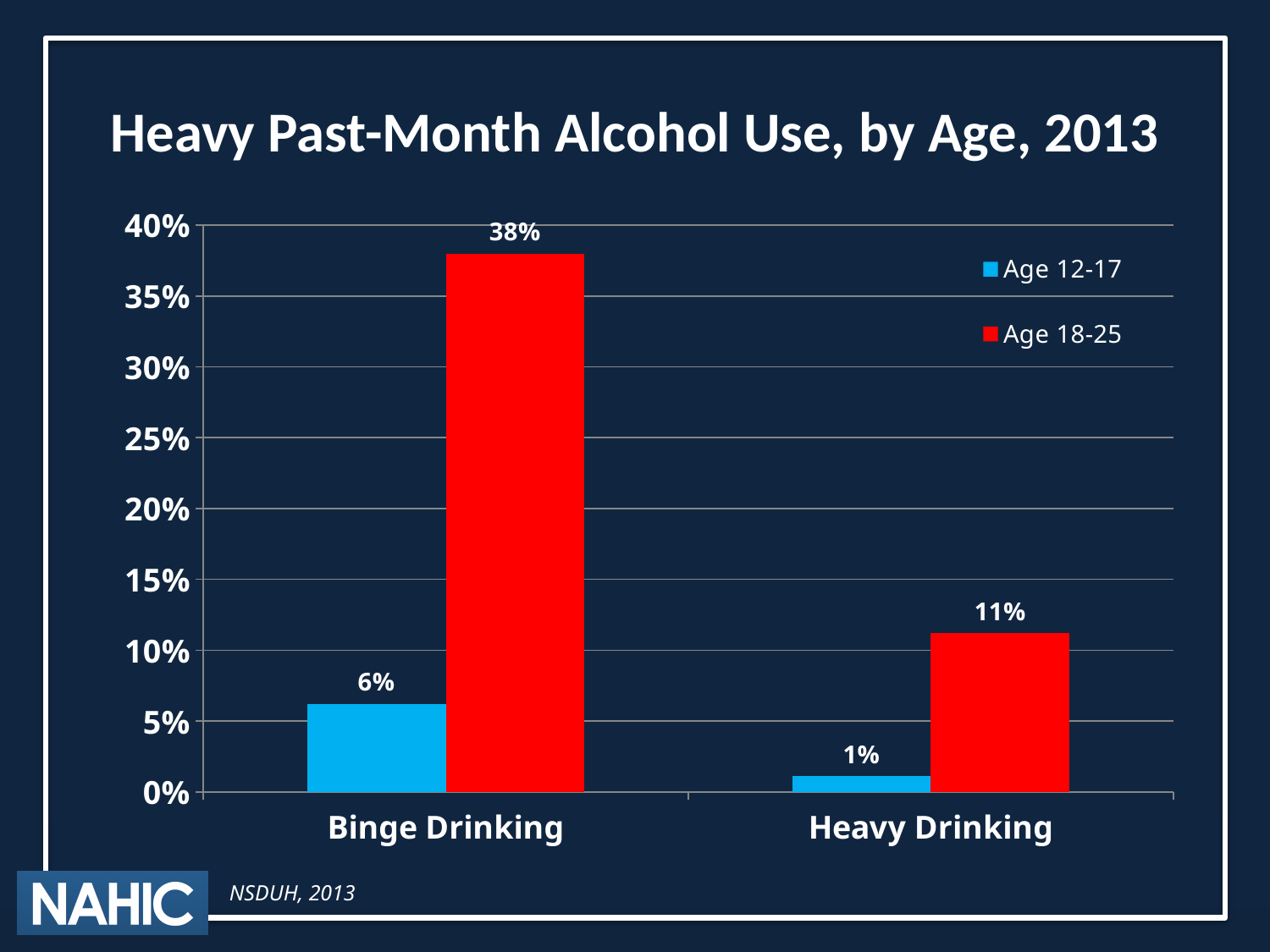
What is the value for Age 18-25 in the Binge Drinking category? 38% Which bar has the highest value on the chart? Age 18-25, Binge Drinking What type of chart is shown on the slide? Bar chart How many series does the legend list? 2 What is the difference between the Age 18-25 and Age 12-17 values for Binge Drinking? 32% What is the difference between the Age 18-25 and Age 12-17 values for Heavy Drinking? 10% Which bar has the lowest value on the chart? Age 12-17, Heavy Drinking What is the value for Age 12-17 in the Binge Drinking category? 6% What is the value for Age 18-25 in the Heavy Drinking category? 11% What is the value for Age 12-17 in the Heavy Drinking category? 1% Which is larger: the Age 12-17 value for Binge Drinking or the Age 18-25 value for Heavy Drinking? Age 18-25 value for Heavy Drinking How many categories are shown on the x axis? 2